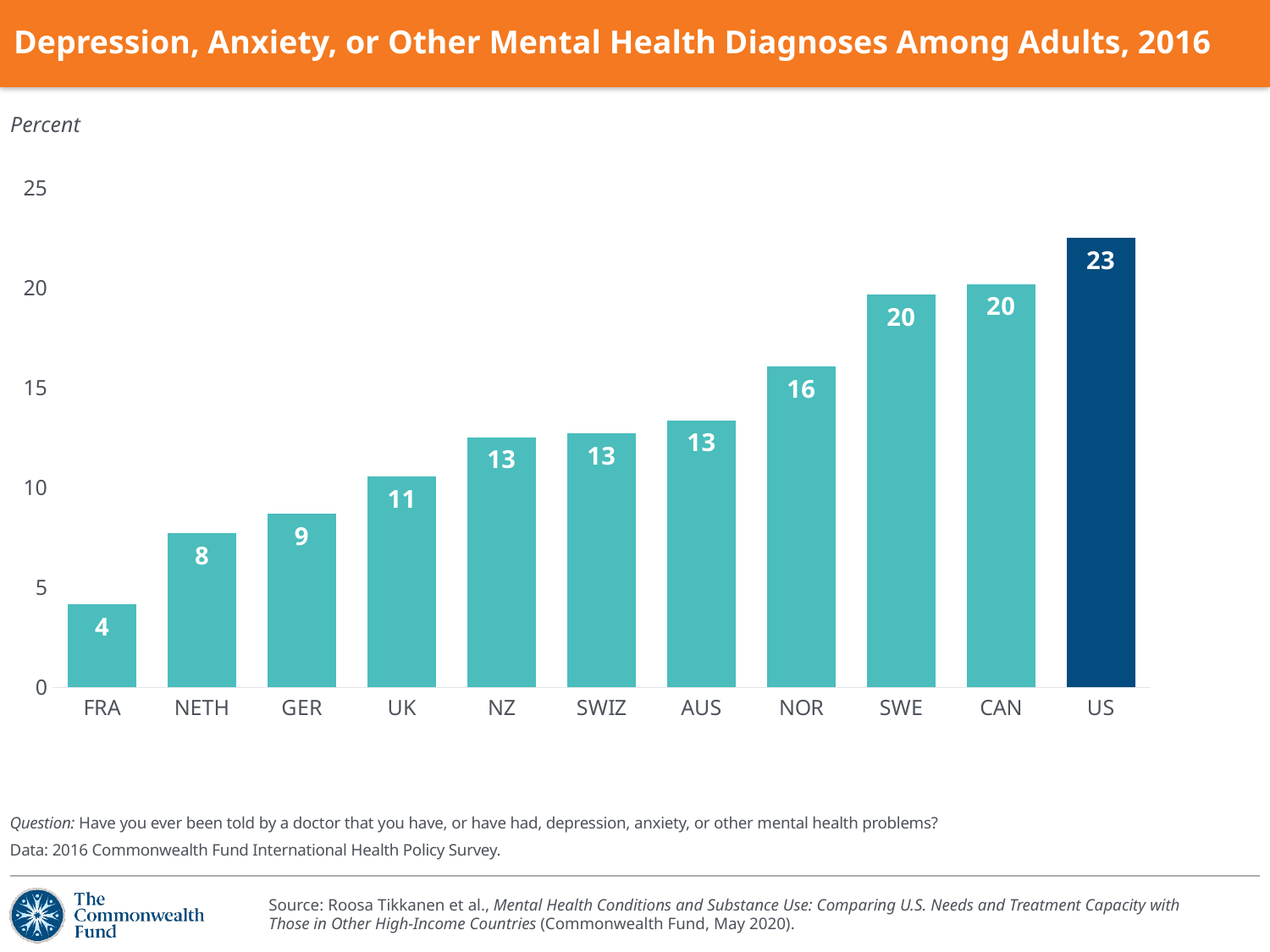
What kind of chart is this? bar chart What is the value for NOR? 16 Which country has the highest value? US Is the value for GER greater or less than 10? less How many countries are shown on the chart? 11 What is the difference between the values for SWE and NETH? 12 What is the value for the US? 23 What is the value for FRA? 4 Do the values rise or fall from left to right along the x axis? rise Which country has the lowest value? FRA What is the difference between the values for the US and CAN? 3 Which has a larger value, UK or NOR? NOR